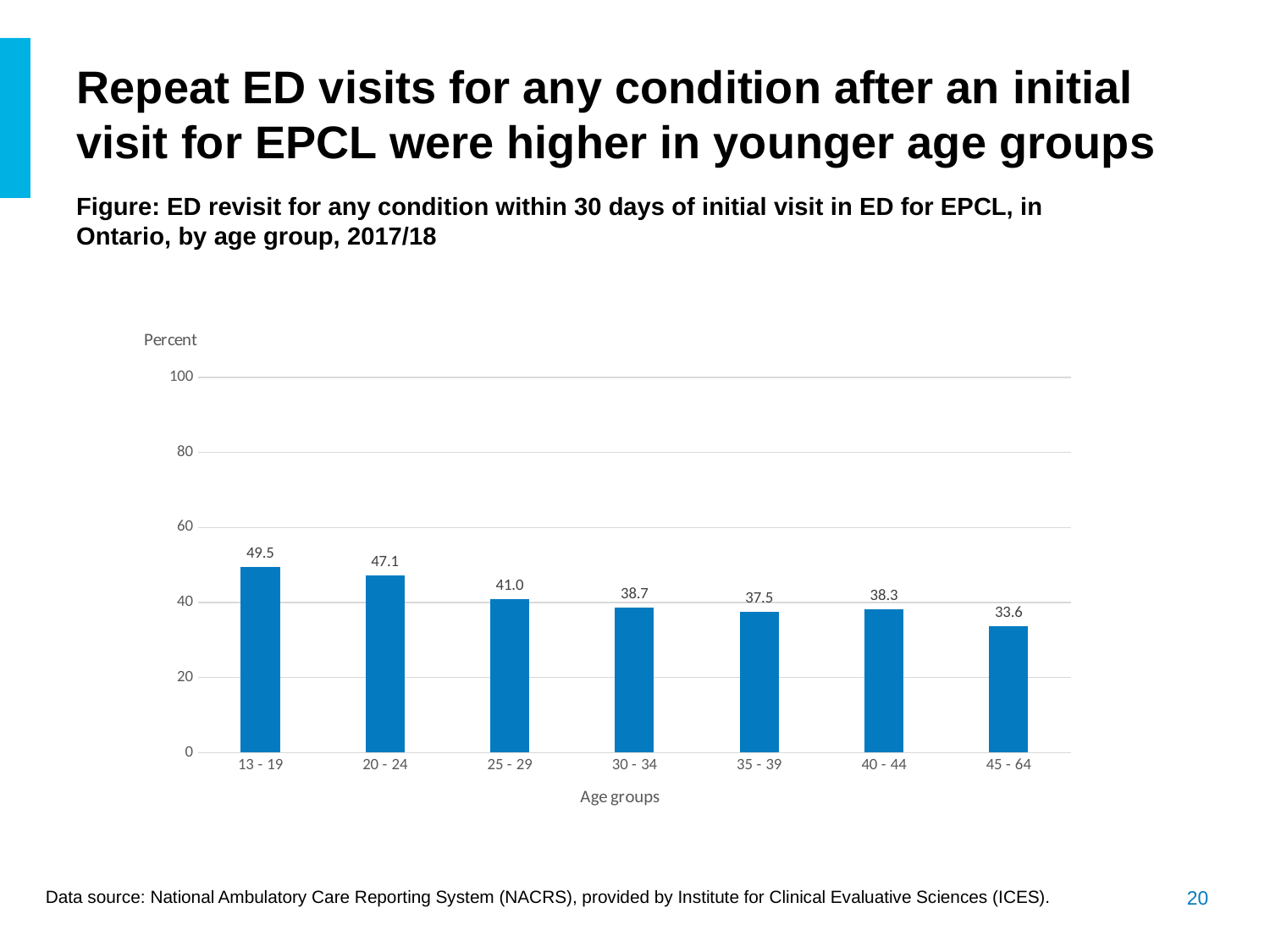
What is the percent value for the 35 - 39 age group? 37.5 Is the value for the 20 - 24 age group greater or less than 40? greater Which age group has the highest percent of ED revisits? 13 - 19 What kind of chart is shown on the slide? Bar chart What is the label of the x axis? Age groups How many age groups are shown on the chart? 7 What is the percent value for the 13 - 19 age group? 49.5 Which age group has a higher value, 30 - 34 or 40 - 44? 30 - 34 What is the difference in percent between the 25 - 29 and 45 - 64 age groups? 7.4 What is the difference in percent between the 13 - 19 and 20 - 24 age groups? 2.4 Which age group has the lowest percent of ED revisits? 45 - 64 What is the percent value for the 45 - 64 age group? 33.6